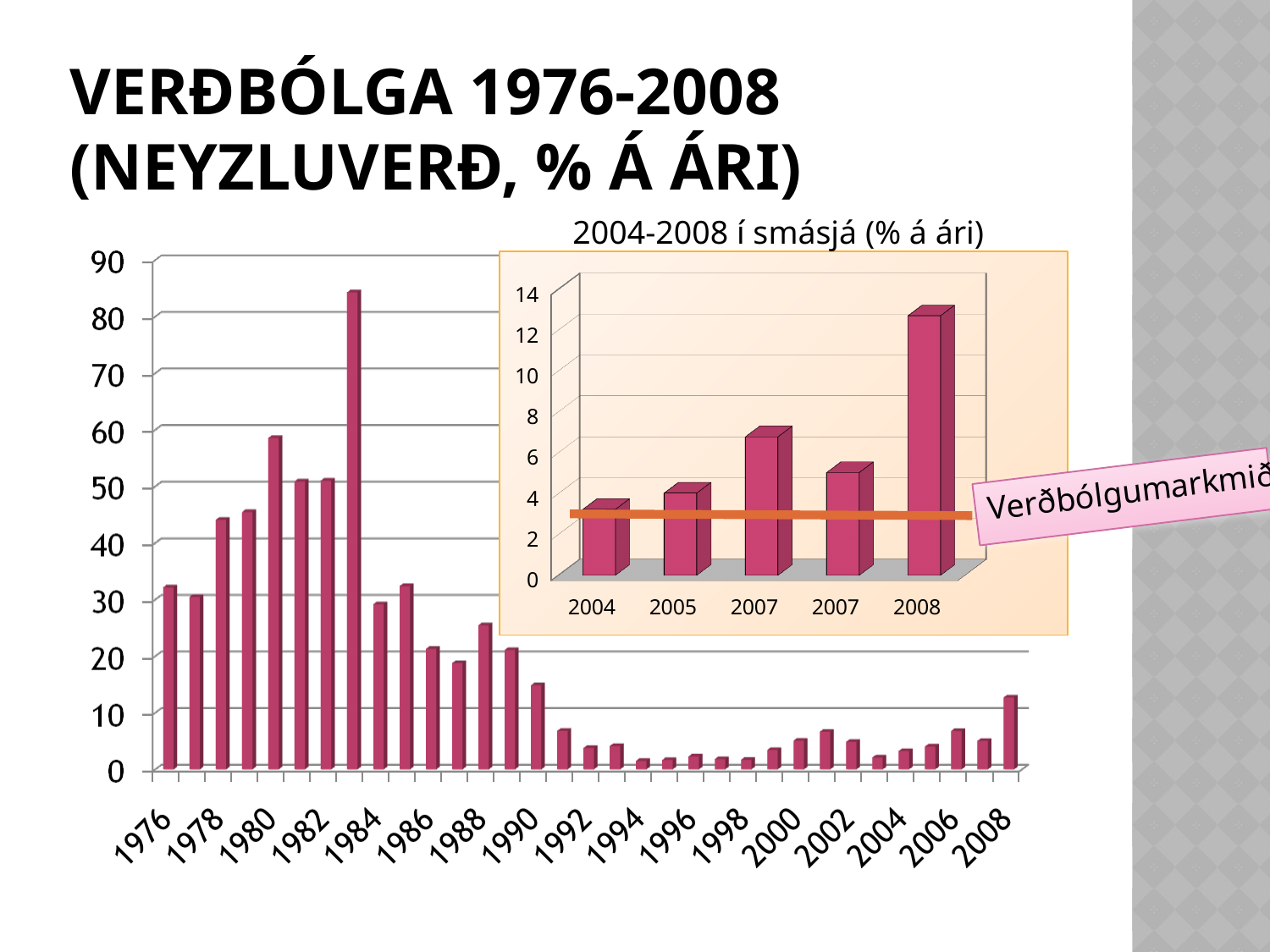
In the inset chart '2004-2008 í smásjá (% á ári)', what does the label on the orange horizontal line say? Verðbólgumarkmið In the inset chart '2004-2008 í smásjá (% á ári)', which year has the lowest value? 2004 What kind of chart is the large chart covering 1976-2008? bar chart In the inset chart '2004-2008 í smásjá (% á ári)', which year has the highest value? 2008 In the large 1976-2008 chart, is the value for 1986 greater or less than 30? less In the large 1976-2008 chart, which year has the highest value? 1983 In the large 1976-2008 chart, is the value for 1980 greater or less than 50? greater In the inset chart '2004-2008 í smásjá (% á ári)', is the value for 2008 greater or less than 12? greater In the inset chart '2004-2008 í smásjá (% á ári)', how many bars are plotted? 5 In the large 1976-2008 chart, do the values rise or fall from 1983 to 1994? fall